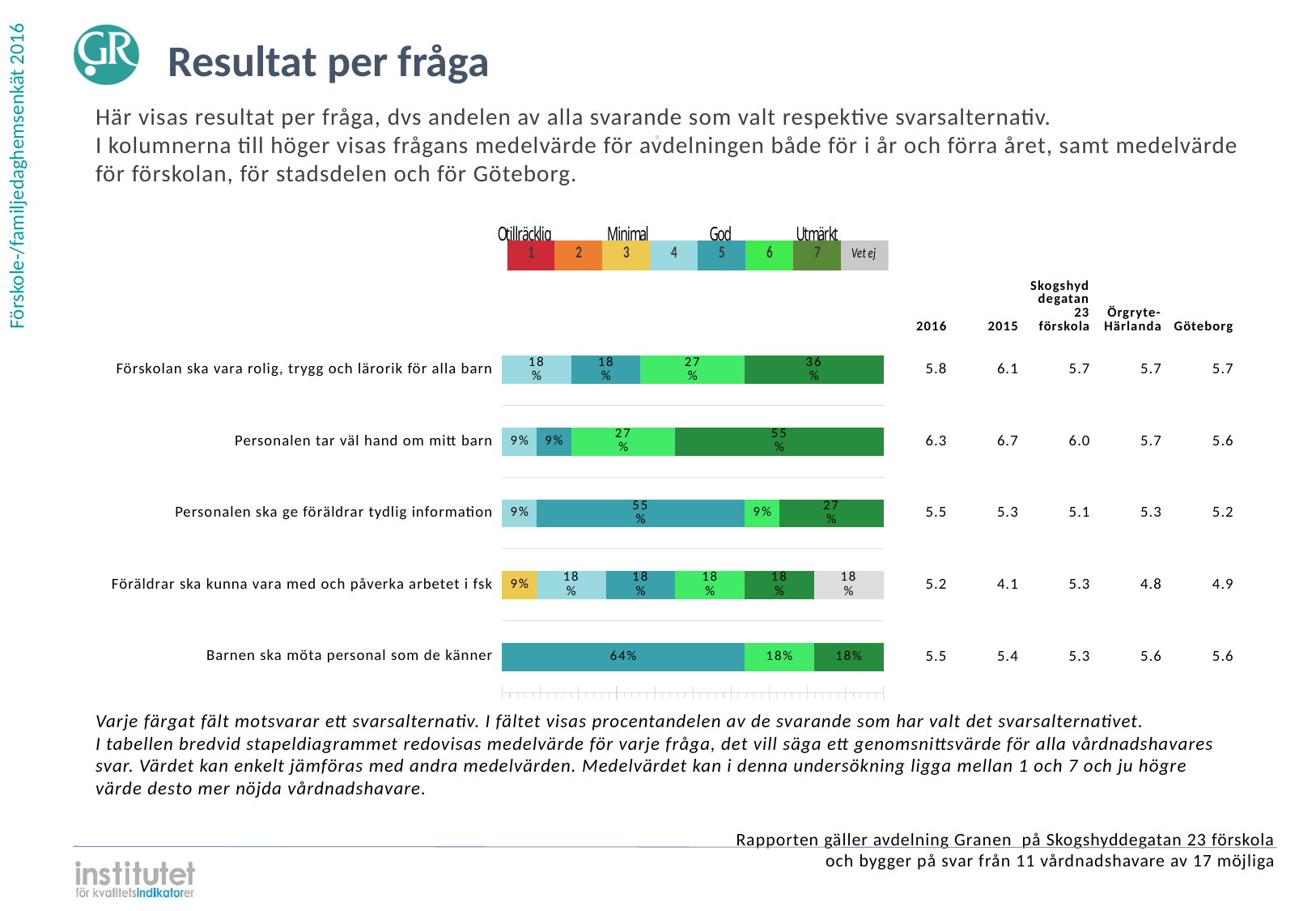
How many answer options does the legend above the chart list? 8 What percentage of respondents answered 'Vet ej' for 'Föräldrar ska kunna vara med och påverka arbetet i fsk'? 18% Which question has the largest share of respondents choosing option 7 (Utmärkt)? Personalen tar väl hand om mitt barn What kind of chart is used to show the results per question? Stacked bar chart What percentage of respondents chose option 7 (Utmärkt) for 'Personalen tar väl hand om mitt barn'? 55% How many questions (categories) are shown in the bar chart? 5 What is the difference between the option 7 share for 'Personalen tar väl hand om mitt barn' (55%) and for 'Förskolan ska vara rolig, trygg och lärorik för alla barn' (36%)? 19 percentage points Which is larger: the option 5 share for 'Personalen ska ge föräldrar tydlig information' or the option 5 share for 'Barnen ska möta personal som de känner'? Barnen ska möta personal som de känner What percentage of respondents chose option 5 for 'Barnen ska möta personal som de känner'? 64% What is the total of the printed segment percentages for 'Personalen tar väl hand om mitt barn'? 100% What label does the legend give to answer option 7? Utmärkt What is the 2016 mean value shown for 'Personalen tar väl hand om mitt barn'? 6.3